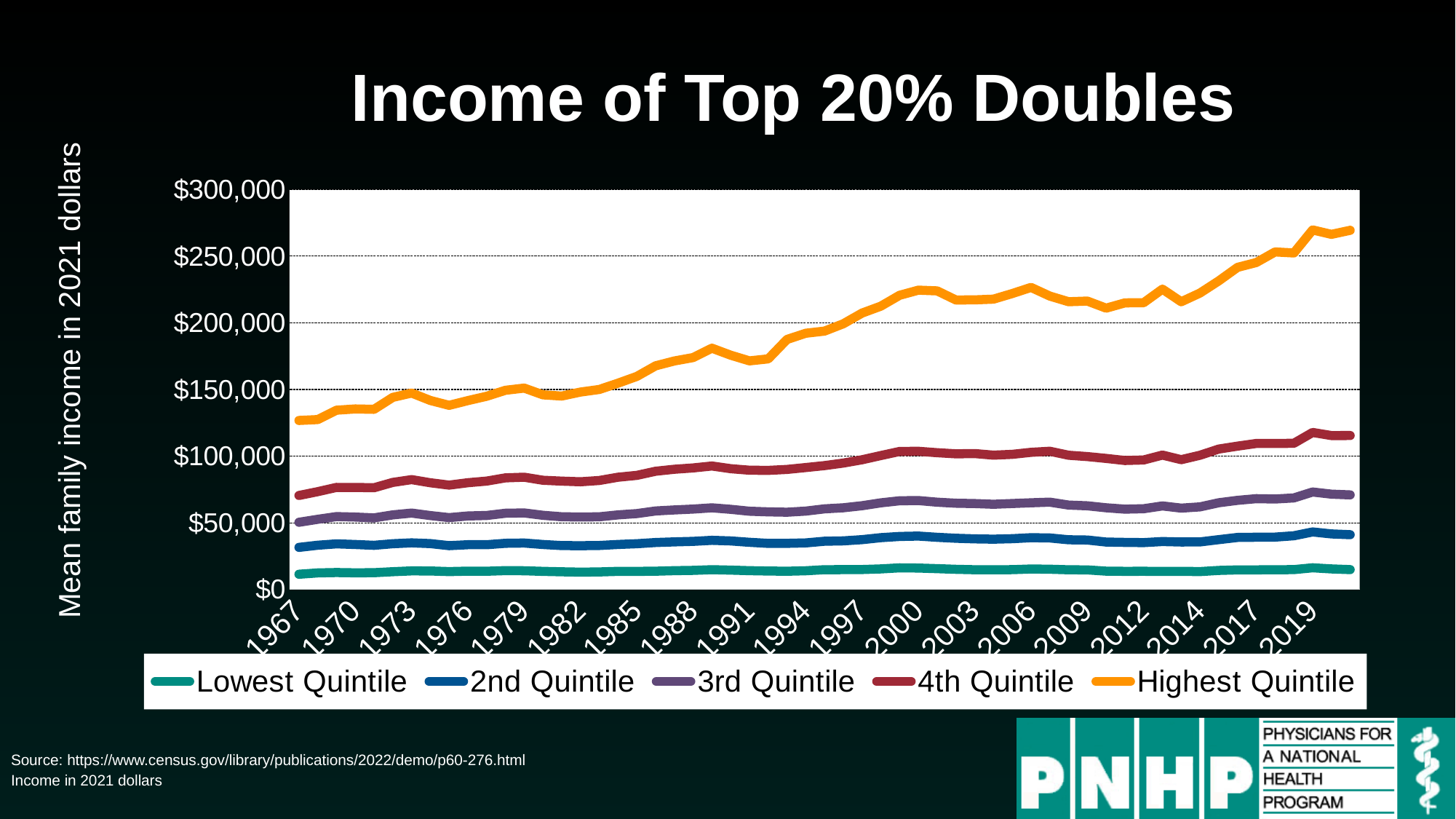
Is the value for the 4th Quintile in 2019 greater or less than $100,000? greater How many series does the legend list? 5 Does the Highest Quintile line rise or fall overall from 1967 to 2019? Rise Which series has the highest values across the chart? Highest Quintile Which series has the lowest values across the chart? Lowest Quintile What is the label on the vertical axis? Mean family income in 2021 dollars Is the value for the Highest Quintile in 1967 greater or less than $100,000? greater Is the value for the Highest Quintile in 1967 greater or less than $150,000? less What kind of chart is shown on the slide? Line chart What is the title of the chart? Income of Top 20% Doubles